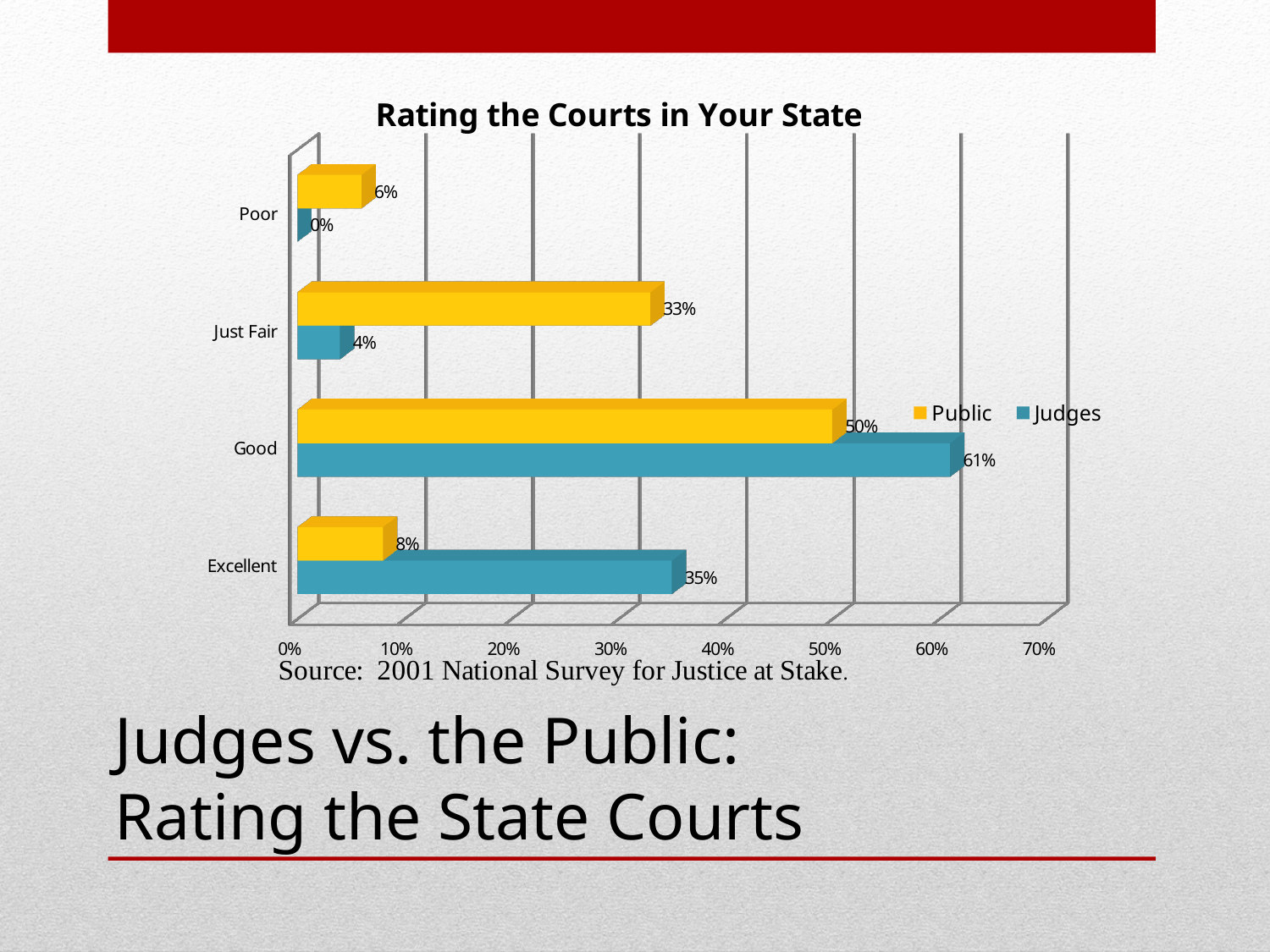
How many series does the legend list? 2 What kind of chart is shown on the slide? Bar chart What percentage of the Public rated the courts as Good? 50% Which rating category has the highest value for Judges? Good What is the difference between the Judges and Public values for the Excellent rating? 27% What percentage of the Public rated the courts as Just Fair? 33% For the Just Fair rating, which series has the larger value, Public or Judges? Public Which rating category has the lowest value for the Public? Poor What is the title of the chart? Rating the Courts in Your State What percentage of Judges rated the courts as Excellent? 35% How many rating categories are shown on the chart? 4 What percentage of Judges rated the courts as Poor? 0%